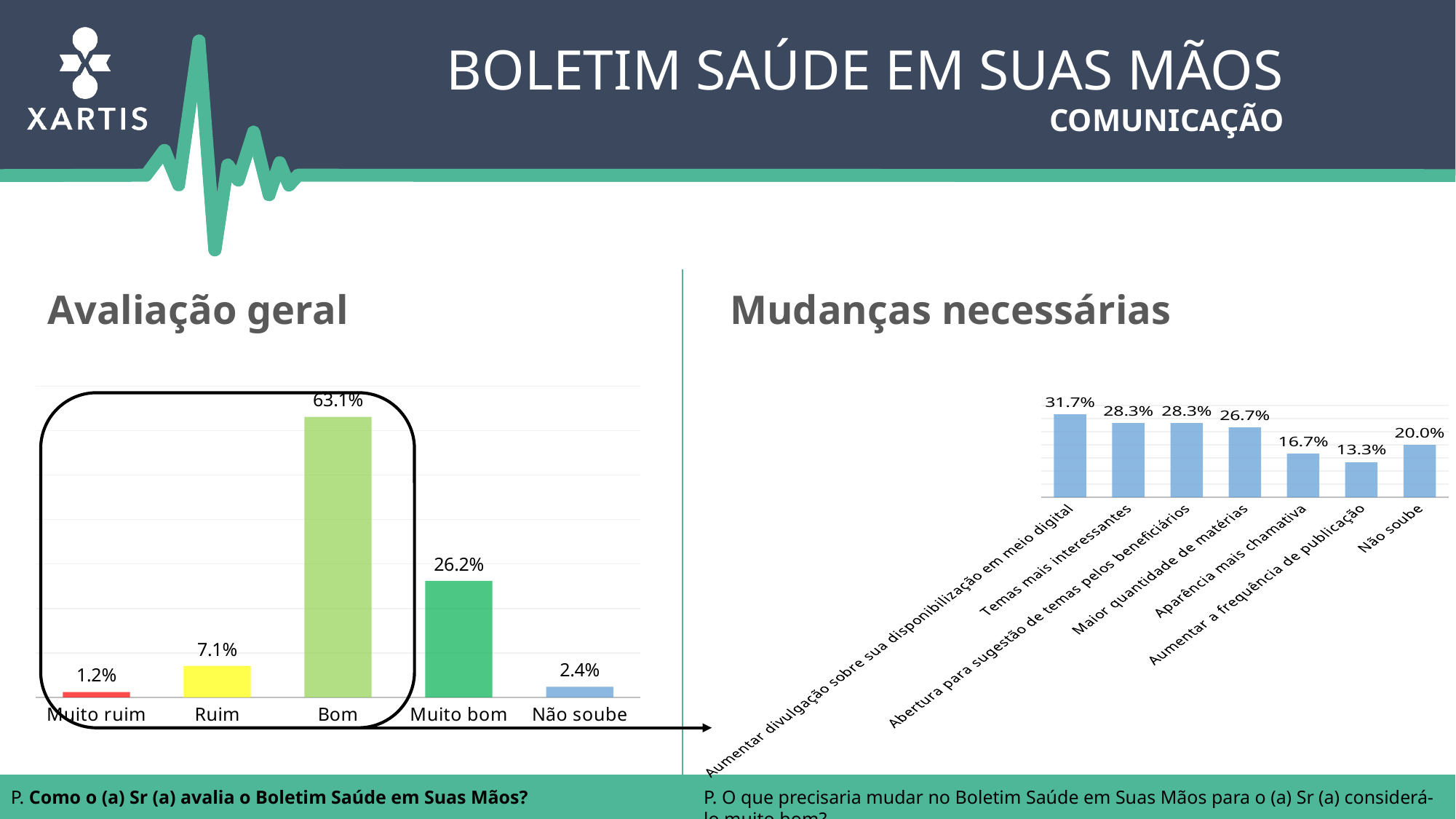
In the 'Avaliação geral' chart, which is larger, 'Ruim' or 'Não soube'? Ruim In the 'Mudanças necessárias' chart, how many categories are shown? 7 In the 'Mudanças necessárias' chart, which category has the highest value? Aumentar divulgação sobre sua disponibilização em meio digital In the 'Avaliação geral' chart, what is the value for 'Bom'? 63.1% In the 'Mudanças necessárias' chart, what is the value for 'Aparência mais chamativa'? 16.7% In the 'Avaliação geral' chart, what is the difference between 'Bom' and 'Muito bom'? 36.9% In the 'Mudanças necessárias' chart, what is the difference between 'Maior quantidade de matérias' and 'Não soube'? 6.7% In the 'Mudanças necessárias' chart, which category has the lowest value? Aumentar a frequência de publicação In the 'Avaliação geral' chart, what is the value for 'Muito bom'? 26.2% In the 'Avaliação geral' chart, how many categories are shown? 5 What type of chart is the 'Mudanças necessárias' chart? Bar chart In the 'Avaliação geral' chart, which category has the lowest value? Muito ruim